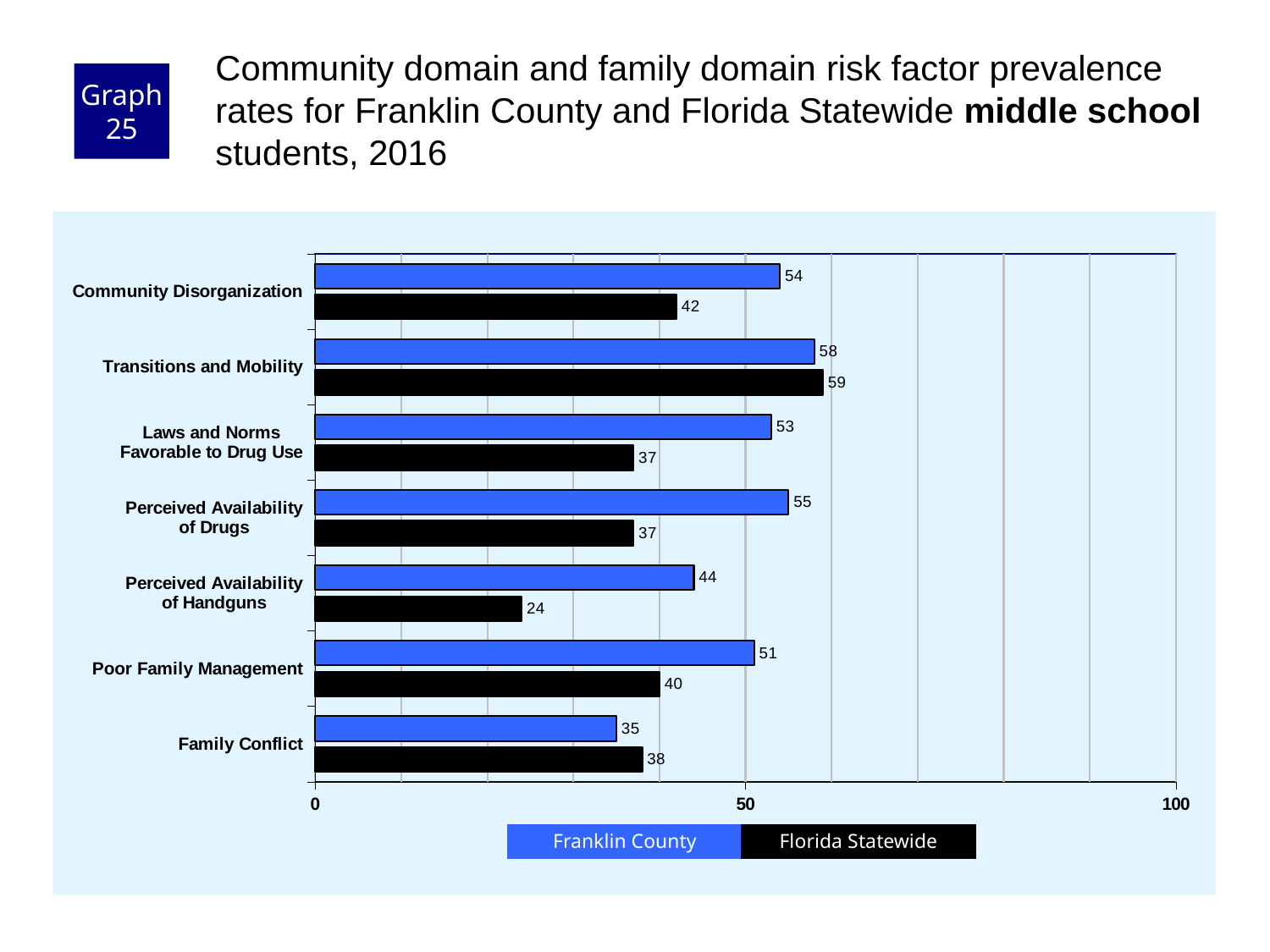
Which risk factor has the highest Franklin County value? Transitions and Mobility How many risk factors are shown on the chart? 7 What is the Franklin County value for Community Disorganization? 54 Is the Franklin County value for Poor Family Management greater or less than 50? greater What kind of chart is shown on the slide? bar chart What is the difference between the Franklin County and Florida Statewide values for Perceived Availability of Drugs? 18 Which risk factor has the lowest Florida Statewide value? Perceived Availability of Handguns For Family Conflict, which is larger: the Franklin County value or the Florida Statewide value? Florida Statewide Which colour represents Florida Statewide in the legend? black What is the Florida Statewide value for Perceived Availability of Handguns? 24 How many series does the legend list? 2 What is the Florida Statewide value for Transitions and Mobility? 59